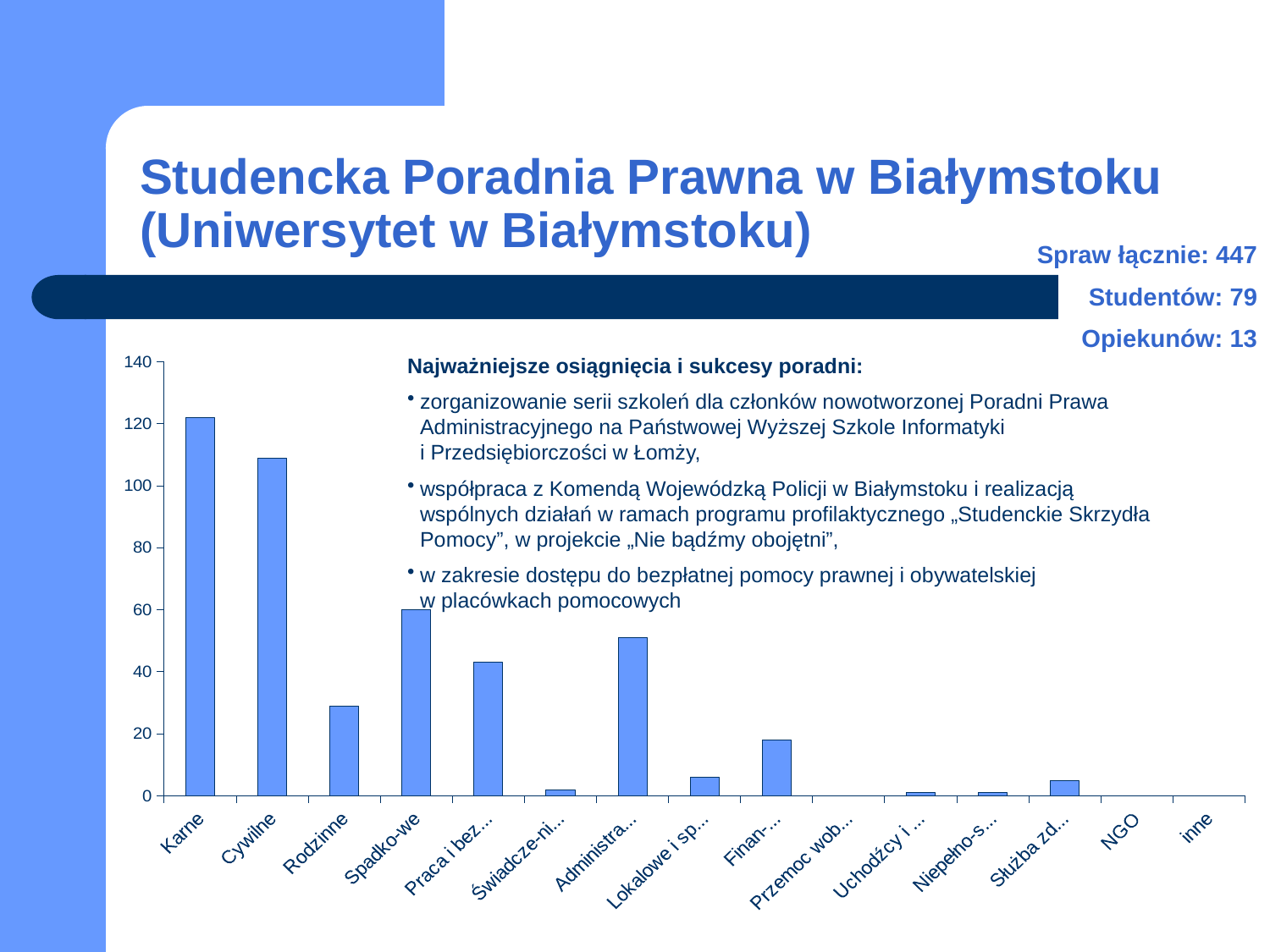
Which is larger, the value for Rodzinne or the value for Praca i bez...? Praca i bez... Is the value for Rodzinne greater or less than 40? less Is the value for Administra... greater or less than 40? greater Is the value for Karne greater or less than 100? greater Which is larger, the value for Karne or the value for Cywilne? Karne Which category has the highest bar in the chart? Karne What is the highest value shown on the y axis of the chart? 140 What kind of chart is shown on the slide? bar chart How many categories are shown on the x axis of the chart? 15